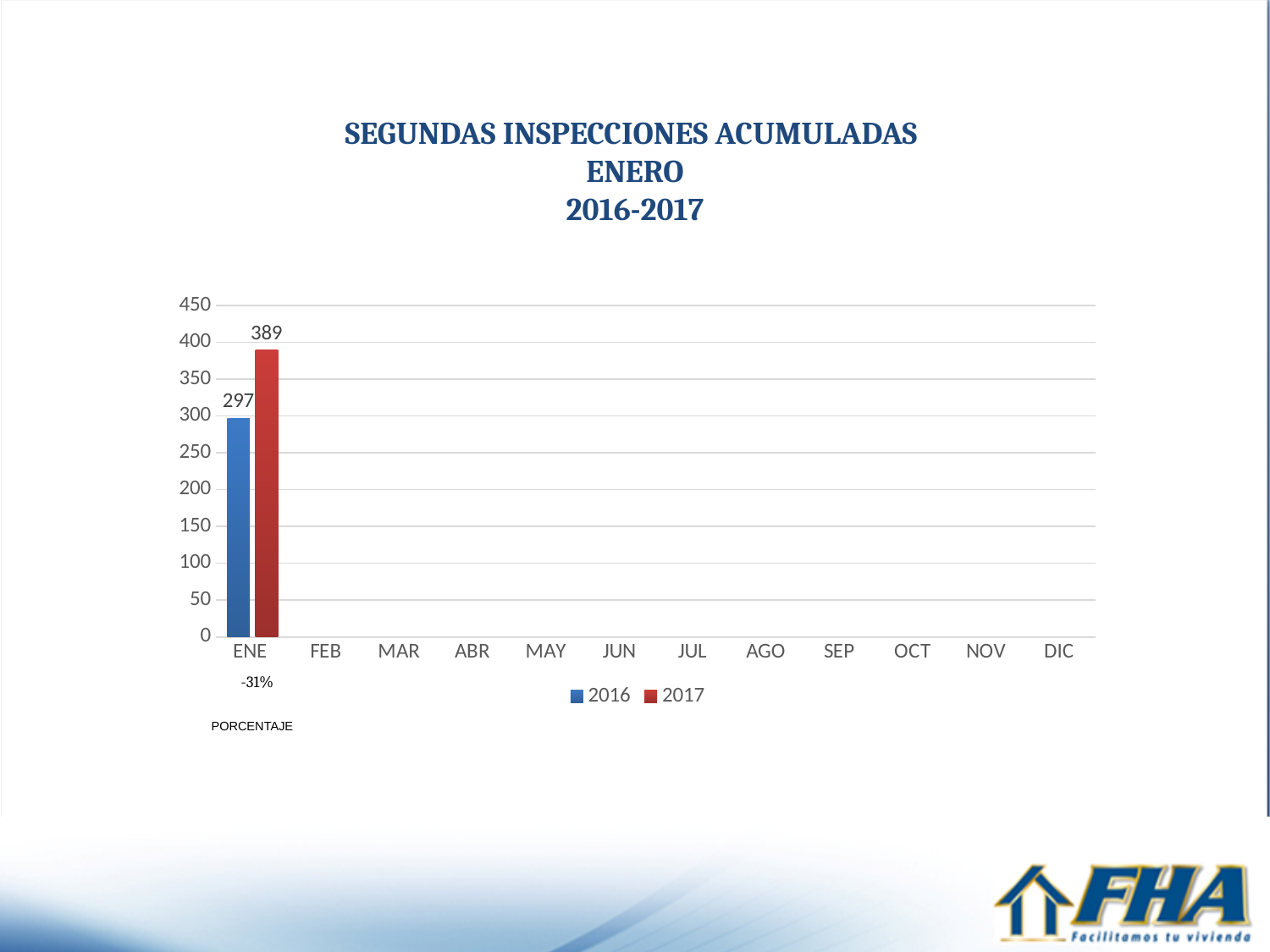
What is the value for 2016 in ENE? 297 How many series does the legend list? 2 What kind of chart is shown on the slide? Bar chart What is the value for 2017 in ENE? 389 What percentage is printed below the ENE category? -31% Which series has the higher value in ENE, 2016 or 2017? 2017 Which month is the only one with bars plotted? ENE How many month categories are shown on the x axis? 12 What is the title of the chart? SEGUNDAS INSPECCIONES ACUMULADAS ENERO 2016-2017 Is the value for 2016 in ENE greater or less than 300? less What is the difference between the 2017 and 2016 values in ENE? 92 Is the value for 2017 in ENE greater or less than 350? greater